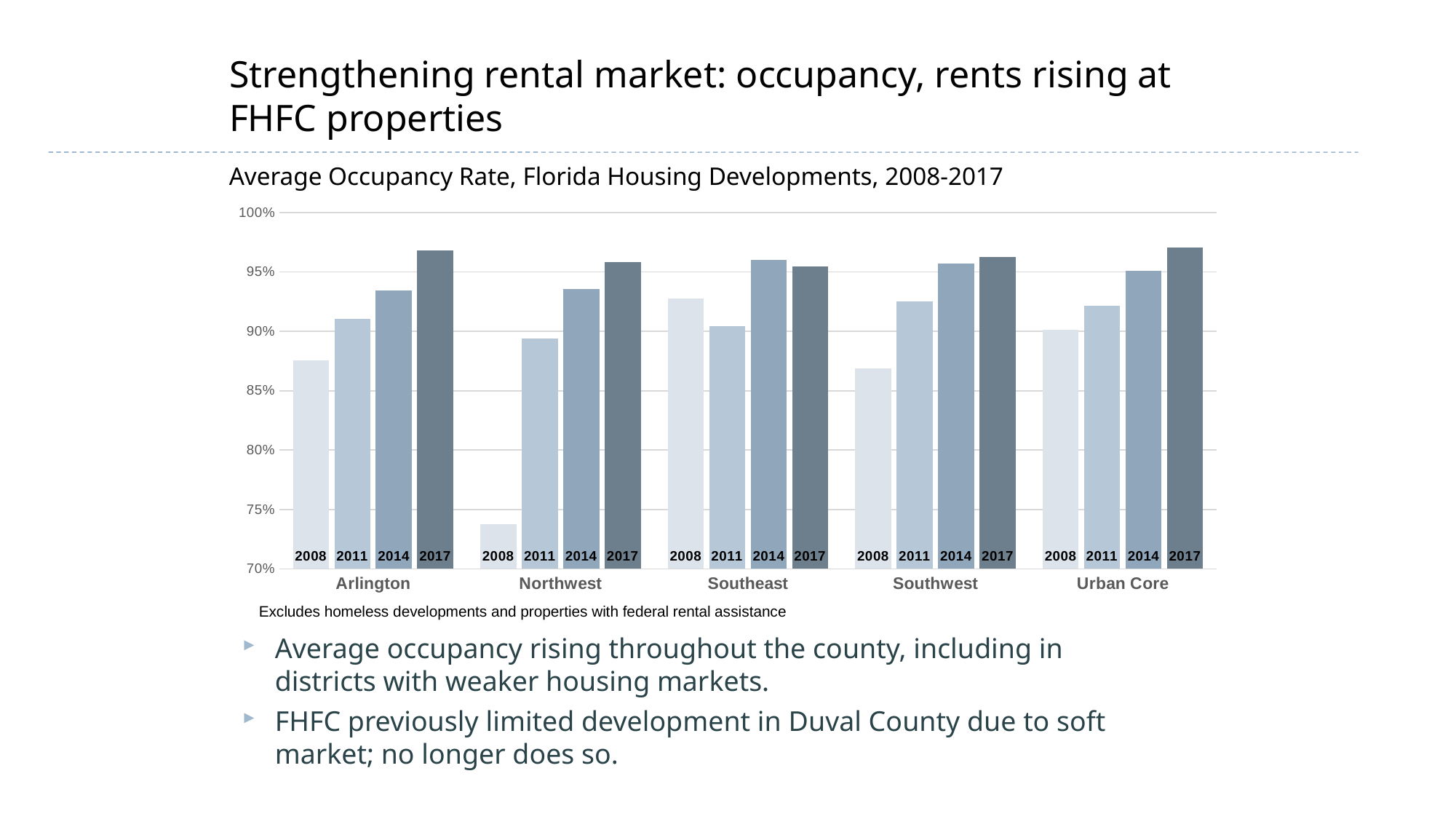
What is the title of the chart? Average Occupancy Rate, Florida Housing Developments, 2008-2017 Is the 2008 occupancy rate for Northwest greater or less than 75%? less Is the 2017 occupancy rate for Urban Core greater or less than 95%? greater Which district had the higher occupancy rate in 2008: Arlington or Northwest? Arlington Is the 2008 occupancy rate for Southeast greater or less than 90%? greater Which is higher for Southeast: the 2008 occupancy rate or the 2011 occupancy rate? 2008 Which district and year has the lowest occupancy rate in the chart? Northwest, 2008 What kind of chart is shown on the slide? Bar chart Do the occupancy rates for Arlington rise or fall from 2008 to 2017? Rise How many districts are shown along the x axis of the chart? 5 How many years are plotted for each district in the chart? 4